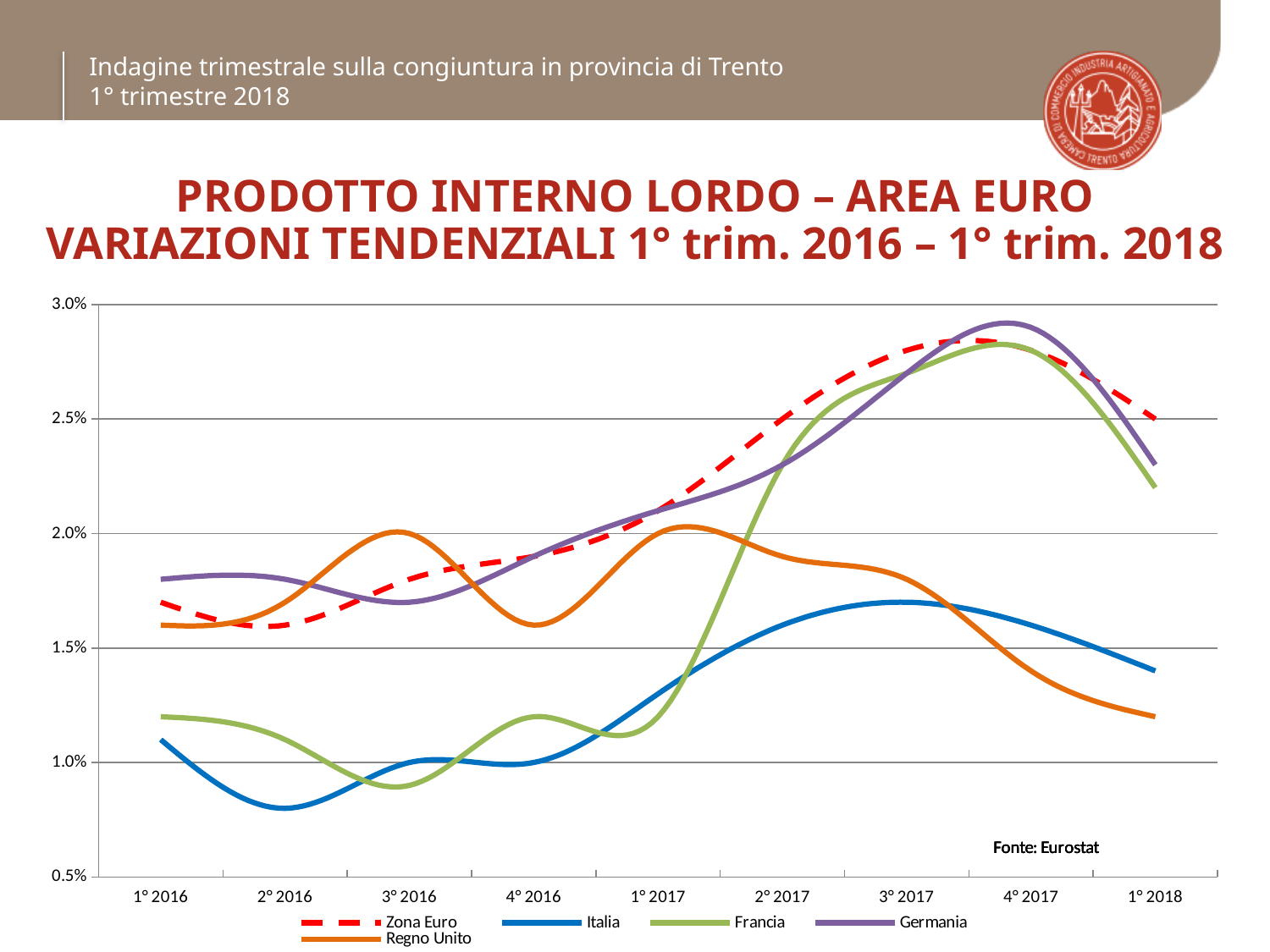
Is the value for Italia in 2° 2016 greater or less than 1.0%? less Does the value for Francia rise or fall from 4° 2016 to 4° 2017? rise Is the value for Germania in 1° 2016 greater or less than 1.5%? greater Is the value for Regno Unito in 1° 2018 greater or less than 1.5%? less How many series does the legend list? 5 Which series is drawn with a dashed line? Zona Euro In 1° 2018, which is larger, the value for Italia or the value for Francia? Francia How many quarters are shown along the x axis? 9 Which series has the lowest value in 2° 2016? Italia What kind of chart is shown on the slide? line chart What source is cited for the data in the chart? Eurostat